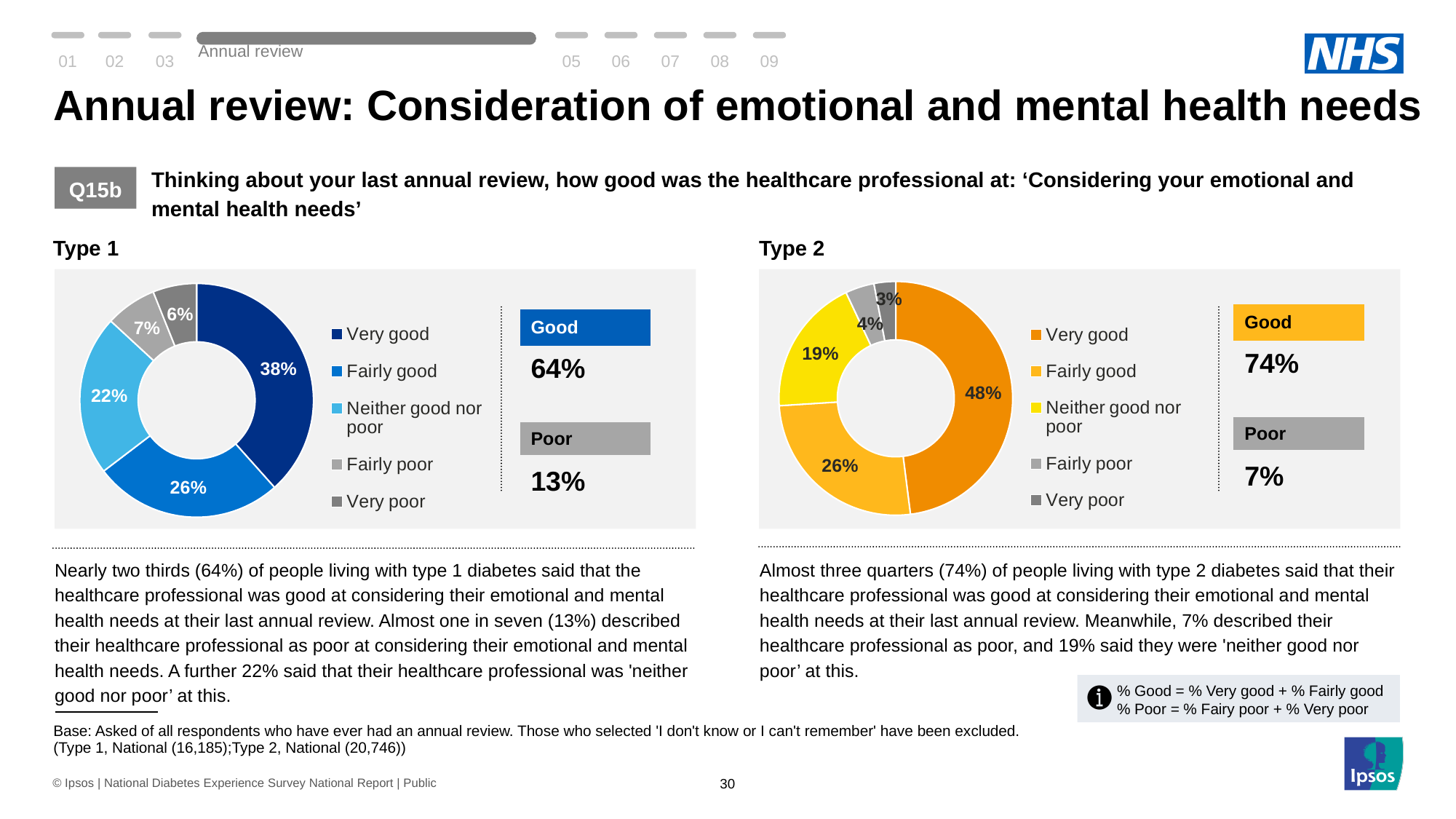
How many categories does the legend of the Type 2 chart list? 5 What kind of chart is used for Type 1? Doughnut chart In the Type 2 chart, what percentage of respondents said 'Fairly good'? 26% In the Type 1 chart, what percentage of respondents said 'Very good'? 38% What is the combined 'Good' percentage shown next to the Type 2 chart? 74% In the Type 2 chart, what percentage of respondents said 'Very poor'? 3% What colour represents 'Very good' in the Type 1 chart? Dark blue In the Type 1 chart, what is the difference between the 'Very good' and 'Fairly good' shares? 12 percentage points In the Type 1 chart, what percentage of respondents said 'Neither good nor poor'? 22% In the Type 1 chart, which category has the smallest share? Very poor In the Type 2 chart, which category has the largest share? Very good Which is larger: the 'Neither good nor poor' share in the Type 1 chart or in the Type 2 chart? Type 1